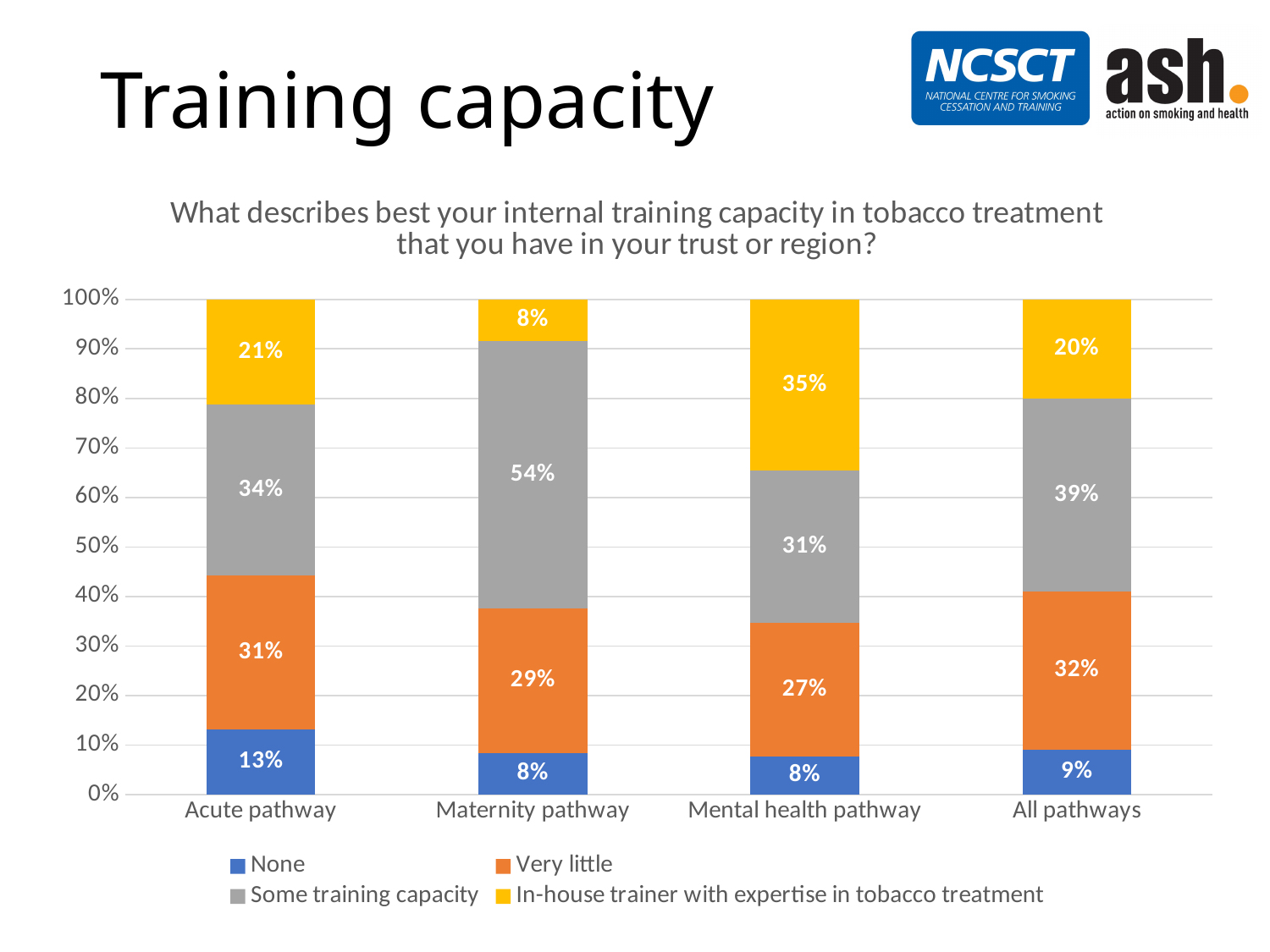
What kind of chart is shown on the slide? Stacked bar chart Which is larger: the 'Very little' value for the Acute pathway or for the Mental health pathway? Acute pathway Which colour represents 'Very little' in the chart? Orange How many pathway categories are shown on the x axis? 4 What is the difference between the 'Some training capacity' values for the Maternity pathway and the Acute pathway? 20% Which pathway has the highest value for 'In-house trainer with expertise in tobacco treatment'? Mental health pathway How many series does the legend list? 4 Which pathway has the lowest value for 'Some training capacity'? Mental health pathway What share of the Mental health pathway reported having an in-house trainer with expertise in tobacco treatment? 35% What percentage of the Acute pathway reported 'None' for internal training capacity? 13% What is the value for 'Some training capacity' in the Maternity pathway? 54% What is the 'Very little' value for All pathways? 32%